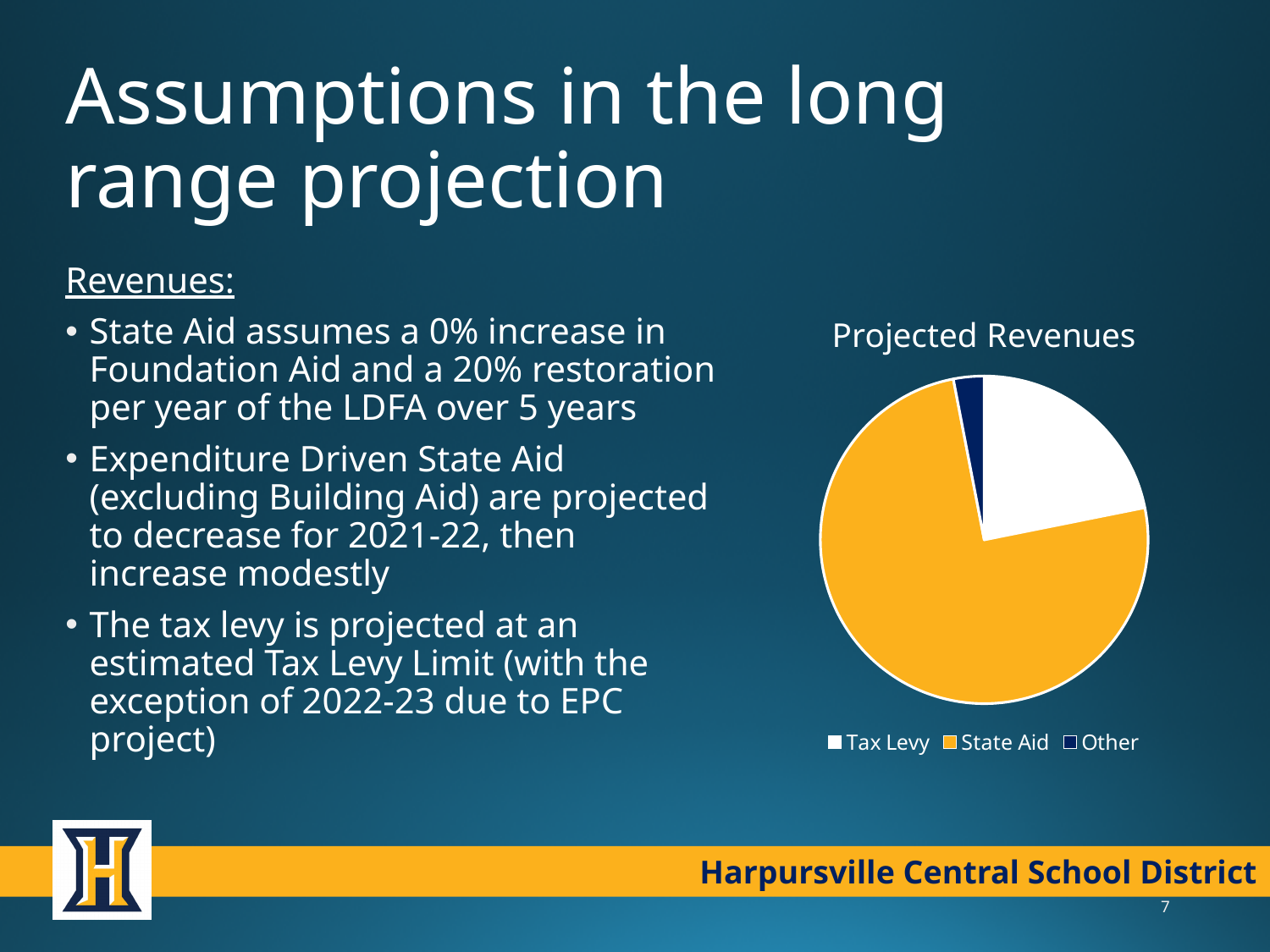
Which category has the largest slice in the Projected Revenues pie chart? State Aid In the Projected Revenues pie chart, which slice is larger: Other or Tax Levy? Other What colour is the State Aid slice in the Projected Revenues pie chart? Yellow In the Projected Revenues pie chart, which slice is larger: Tax Levy or State Aid? State Aid What is the title of the chart on the slide? Projected Revenues How many slices does the Projected Revenues pie chart have? 3 Which category has the smallest slice in the Projected Revenues pie chart? Tax Levy In the Projected Revenues pie chart, which slice is larger: State Aid or Other? State Aid How many entries does the legend of the Projected Revenues chart list? 3 What kind of chart is shown on the slide? Pie chart